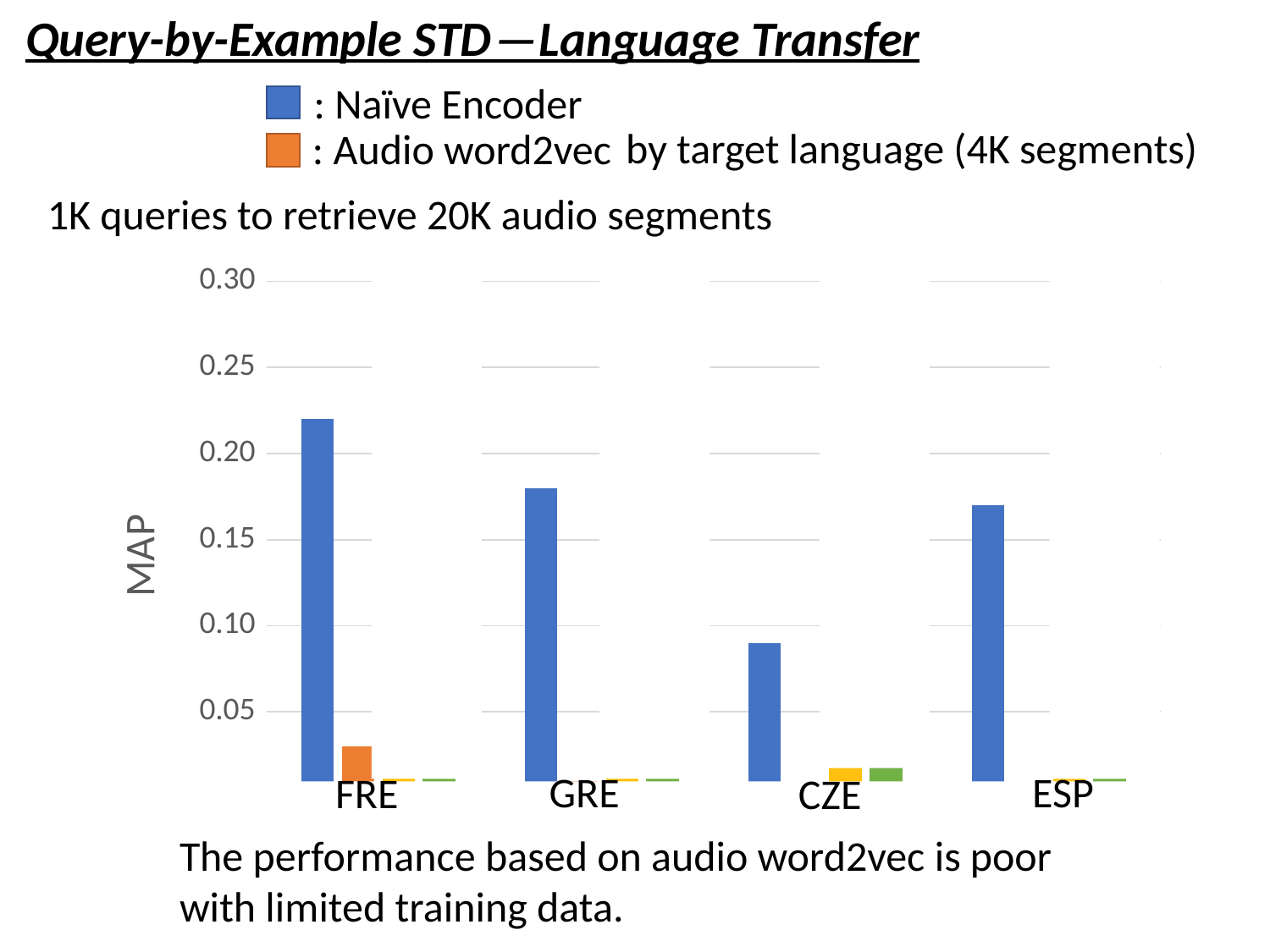
What is the label of the y axis of the chart? MAP How many language categories are shown on the x axis of the chart? 4 Is the Audio word2vec MAP for FRE greater or less than 0.05? less Which has the higher Naïve Encoder MAP, FRE or GRE? FRE Is the Naïve Encoder MAP for ESP greater or less than 0.15? greater Is the Naïve Encoder MAP for CZE greater or less than 0.10? less Which language has the highest MAP for the Naïve Encoder? FRE What kind of chart is shown on the slide? bar chart How many series does the legend list? 2 Which language has the lowest MAP for the Naïve Encoder? CZE